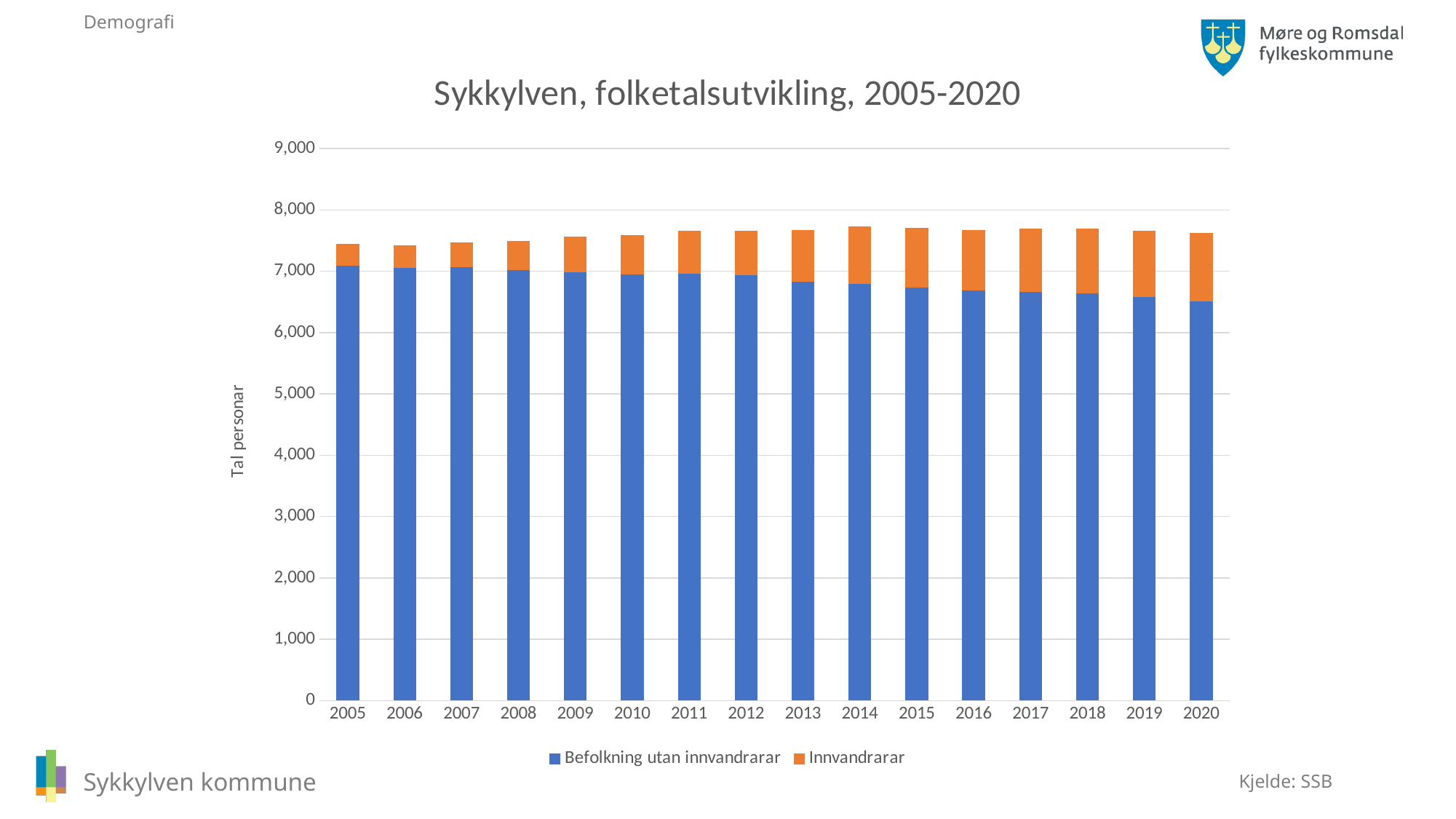
Is the total height of the stacked bar for 2014 greater or less than 8,000? less What is the title of the chart? Sykkylven, folketalsutvikling, 2005-2020 Does the value for Innvandrarar rise or fall from 2005 to 2020? Rise Which is larger: the Innvandrarar value in 2005 or in 2020? 2020 Is the value for Befolkning utan innvandrarar in 2005 greater or less than 7,000? greater What is the label on the y axis? Tal personar What kind of chart is shown on the slide? Stacked bar chart Does the value for Befolkning utan innvandrarar rise or fall from 2005 to 2020? Fall How many series does the legend list? 2 Which is larger: the Befolkning utan innvandrarar value in 2005 or in 2020? 2005 Is the value for Befolkning utan innvandrarar in 2020 greater or less than 7,000? less How many years are shown on the x axis? 16